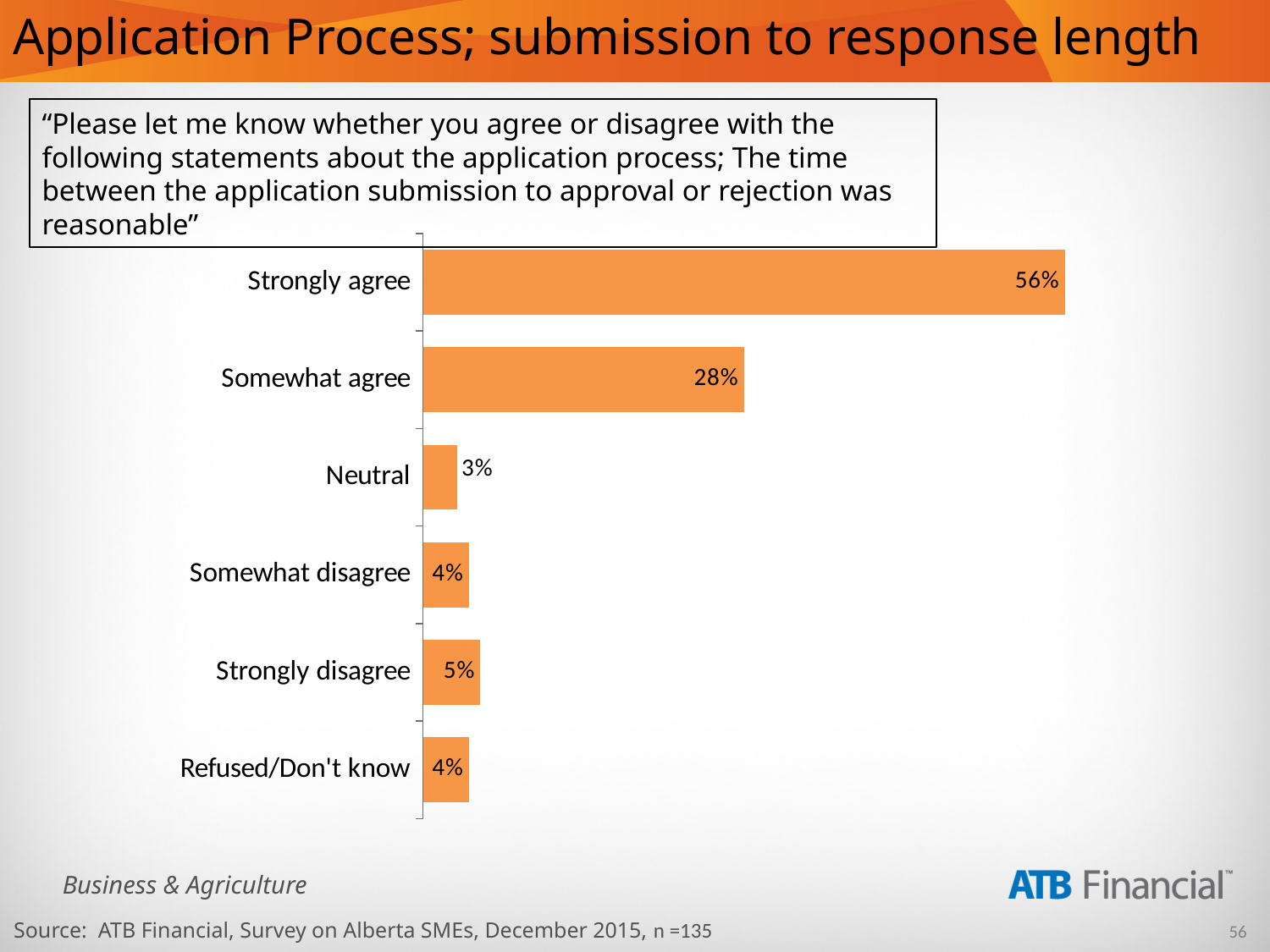
What is the difference between "Strongly agree" and "Somewhat agree"? 28% What is the value for "Neutral"? 3% How many response categories are shown in the chart? 6 Which response category has the highest value? Strongly agree What percentage of respondents answered "Strongly agree"? 56% Which response category has the lowest value? Neutral What is the combined value of "Strongly agree" and "Somewhat agree"? 84% Which is larger, "Strongly disagree" or "Somewhat disagree"? Strongly disagree What kind of chart is shown on the slide? Bar chart What is the sample size (n) given in the source note? 135 What is the value for "Strongly disagree"? 5% What percentage of respondents answered "Somewhat agree"? 28%